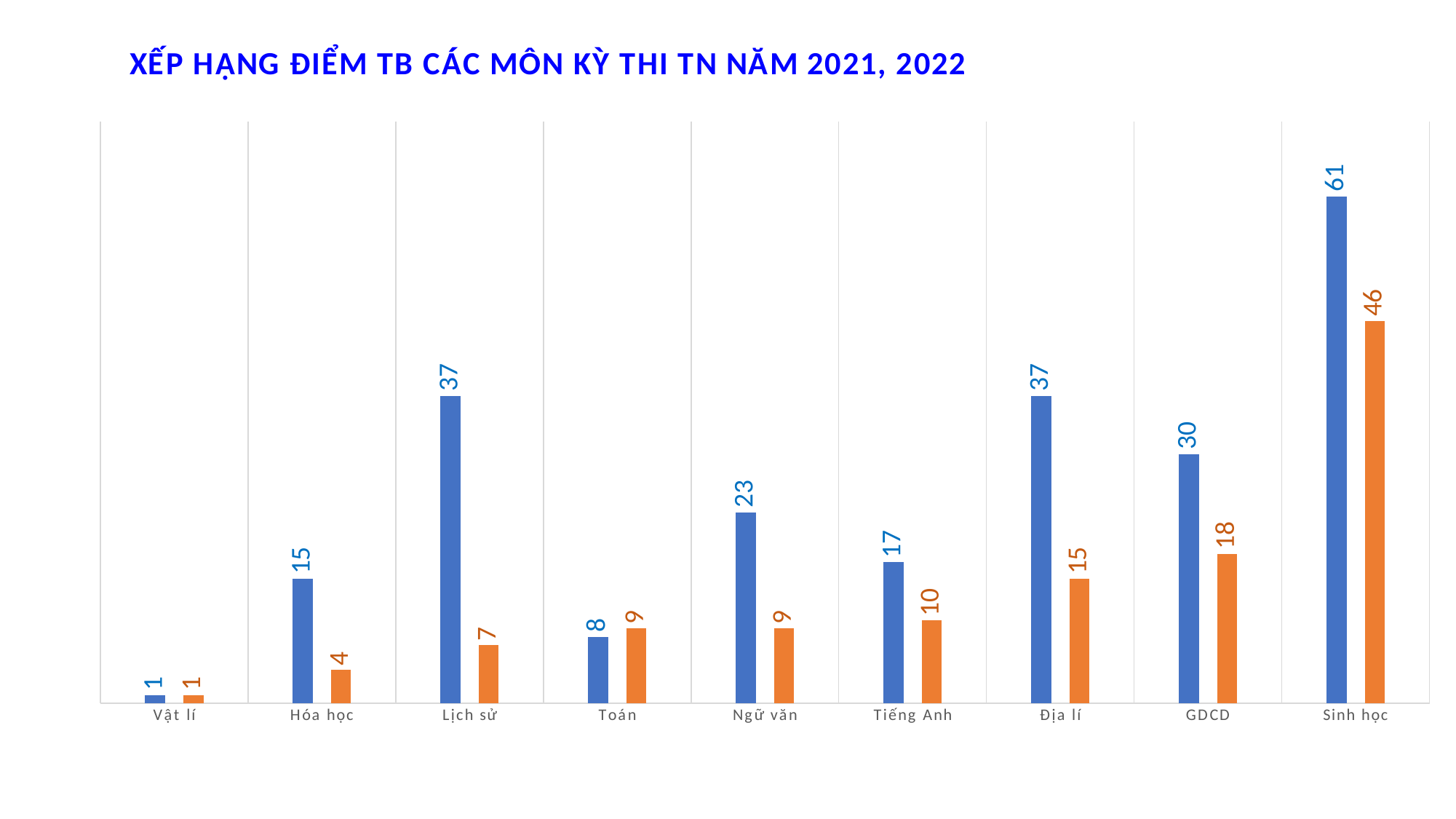
What is the value of the orange bar for GDCD? 18 Which category has the lowest orange bar? Vật lí What kind of chart is shown on the slide? bar chart What is the difference between the blue bars for Sinh học and GDCD? 31 For Toán, which bar is larger, the blue or the orange? orange What is the value of the orange bar for Lịch sử? 7 How many categories are shown on the x axis? 9 What is the value of the blue bar for Ngữ văn? 23 What is the difference between the blue and orange bars for Địa lí? 22 Which category has the highest blue bar? Sinh học What is the value of the blue bar for Sinh học? 61 What is the title of the chart? XẾP HẠNG ĐIỂM TB CÁC MÔN KỲ THI TN NĂM 2021, 2022